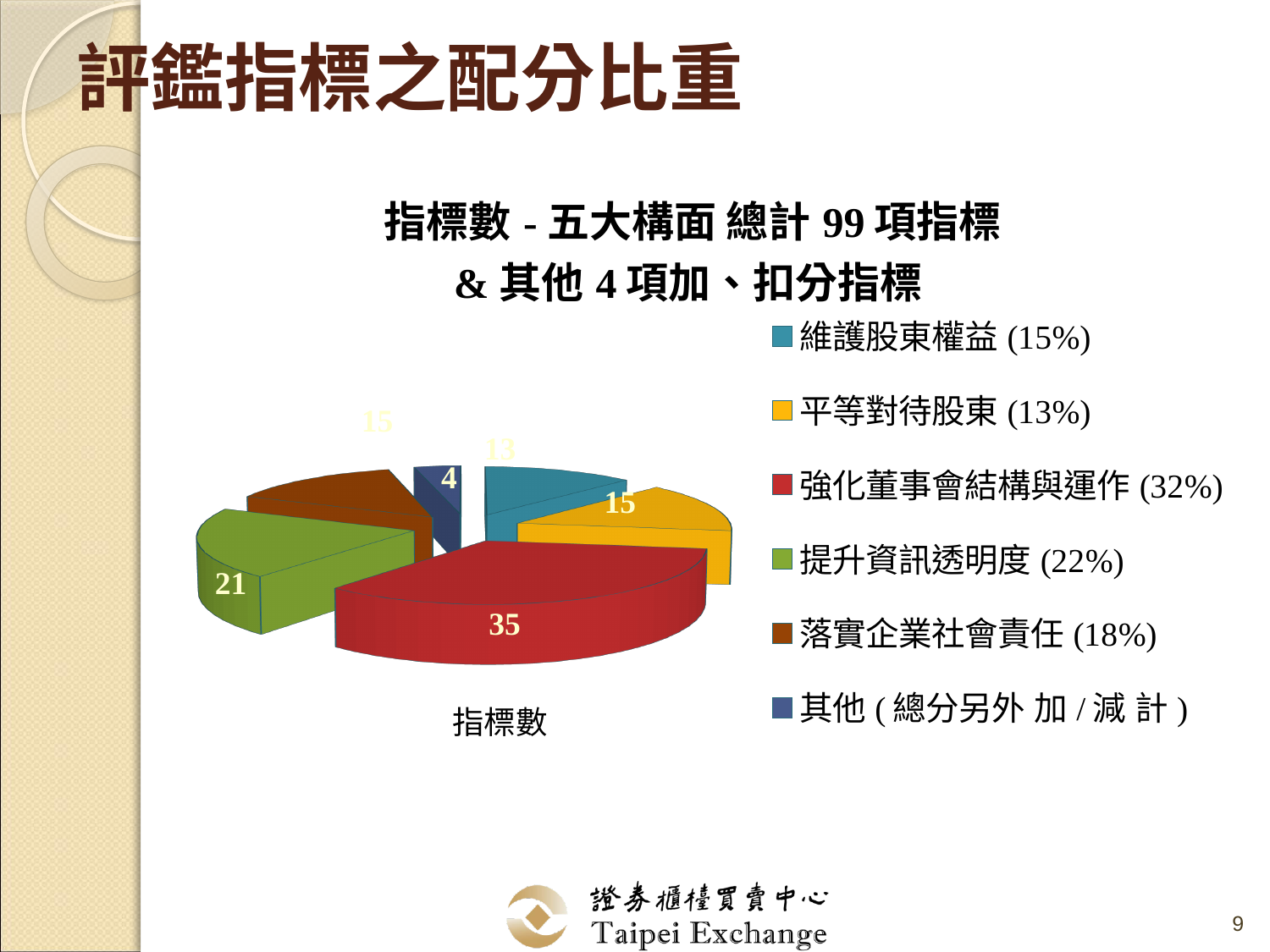
What is the value of the 提升資訊透明度 slice? 21 What is the difference between the 強化董事會結構與運作 slice and the 提升資訊透明度 slice? 14 How many slices does the pie chart have? 6 According to the legend, what percentage share is given for 強化董事會結構與運作? 32% Which category has the smallest slice in the pie chart? 其他 What kind of chart is shown on the slide? pie chart What is the value of the 其他 slice? 4 What is the value of the 強化董事會結構與運作 slice? 35 What is the title of the pie chart? 指標數 - 五大構面 總計 99 項指標 & 其他 4 項加、扣分指標 Which is larger, the 提升資訊透明度 slice or the 其他 slice? 提升資訊透明度 How many entries does the legend list? 6 Which category has the largest slice in the pie chart? 強化董事會結構與運作